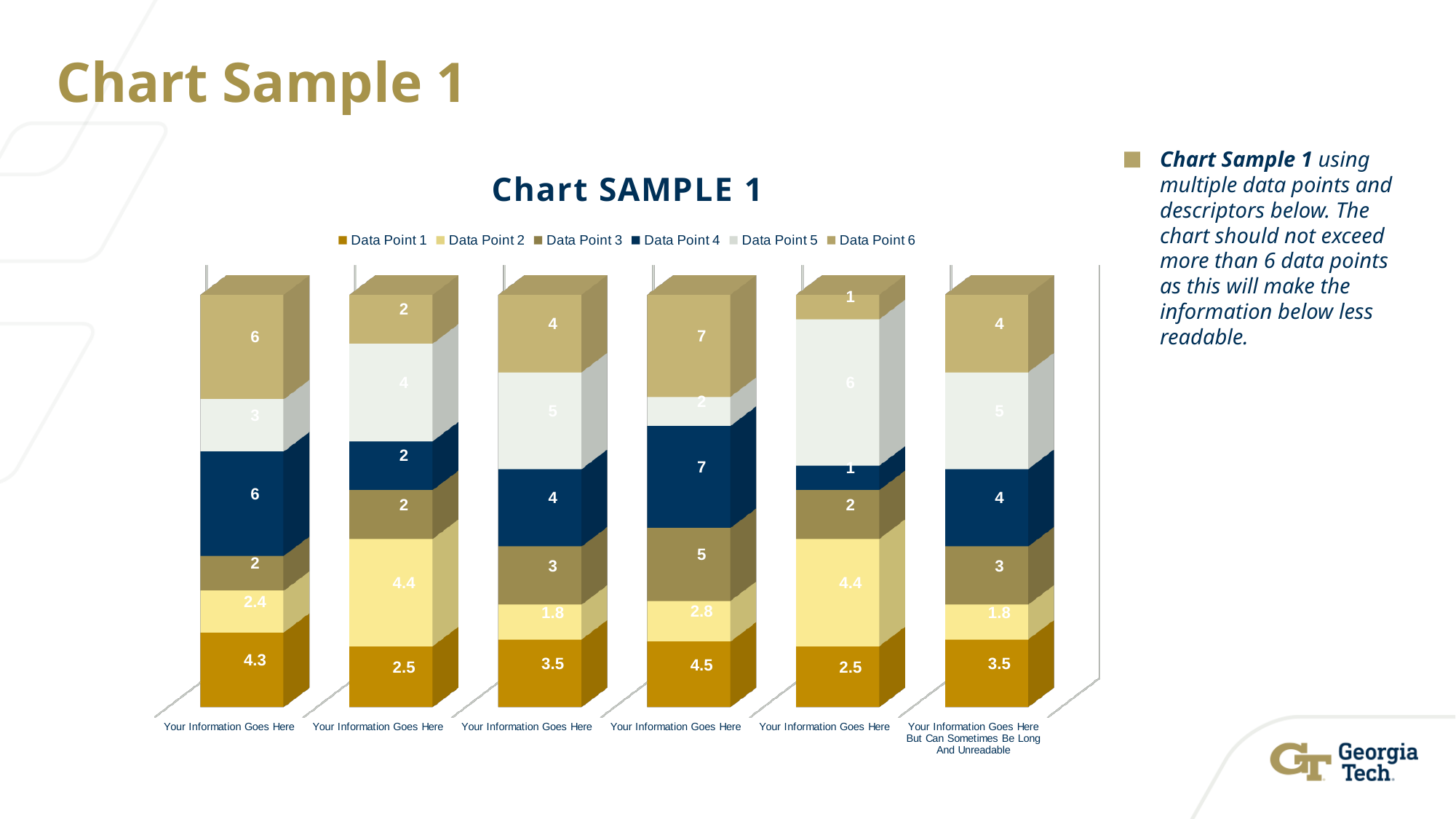
What is the Data Point 5 value for the fifth bar from the left? 6 What is the Data Point 1 value for the first (leftmost) bar? 4.3 What is the difference between the Data Point 1 values of the first bar and the second bar? 1.8 How many bars (categories) are plotted in the chart? 6 What is the total of the stacked values in the fourth bar from the left? 28.3 How many series does the legend list? 6 What kind of chart is shown on the slide? Stacked bar chart What is the title of the chart? Chart SAMPLE 1 Which bar has the highest Data Point 1 value? The fourth bar from the left (4.5) What is the Data Point 4 value for the fourth bar from the left? 7 What is the Data Point 2 value for the second bar from the left? 4.4 Which bar has the lowest Data Point 6 value? The fifth bar from the left (1)